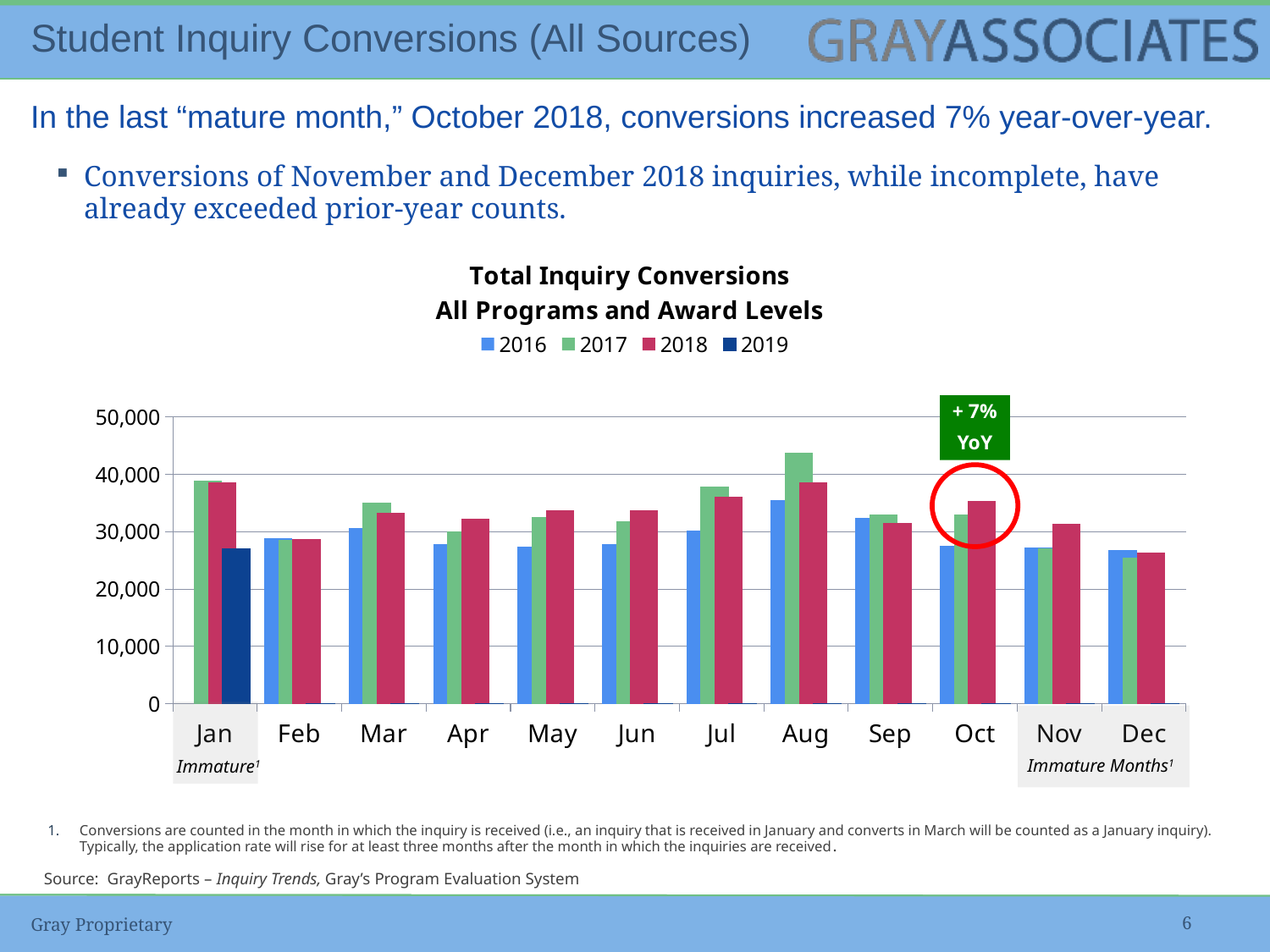
Is the value for 2017 in Aug greater or less than 40,000? greater In which month is the 2016 series highest? Aug In which month is the 2017 series highest? Aug In Aug, which is larger: the 2017 value or the 2018 value? 2017 Is the value for 2019 in Jan greater or less than 30,000? less What kind of chart is shown on the slide? Bar chart How many series does the chart legend list? 4 Is the value for 2018 in Oct greater or less than 30,000? greater What year-over-year change is annotated above the Oct bars? + 7% YoY How many months are shown along the x axis of the chart? 12 In Nov, which is larger: the 2017 value or the 2018 value? 2018